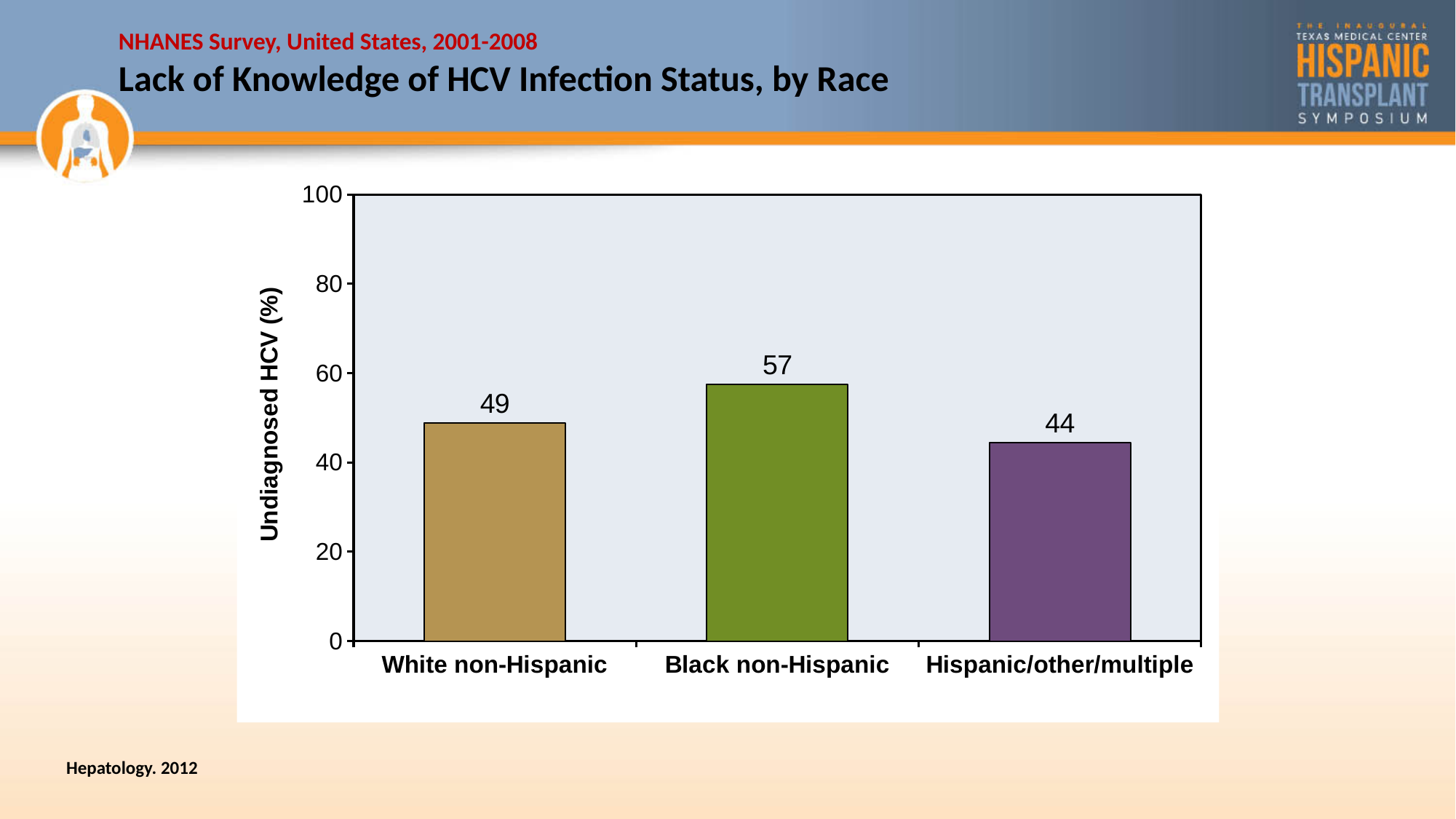
How many race categories are shown in the chart? 3 What is the label of the y axis? Undiagnosed HCV (%) What kind of chart is shown on the slide? bar chart What is the undiagnosed HCV percentage for White non-Hispanic? 49 What is the difference between the undiagnosed HCV percentages for Black non-Hispanic and White non-Hispanic? 8 What is the undiagnosed HCV percentage for Hispanic/other/multiple? 44 Which race category has the highest undiagnosed HCV percentage? Black non-Hispanic Is the value for Black non-Hispanic greater or less than 60? less What is the undiagnosed HCV percentage for Black non-Hispanic? 57 Which race category has the lowest undiagnosed HCV percentage? Hispanic/other/multiple What is the difference between the undiagnosed HCV percentages for White non-Hispanic and Hispanic/other/multiple? 5 Which has a higher undiagnosed HCV percentage, White non-Hispanic or Hispanic/other/multiple? White non-Hispanic